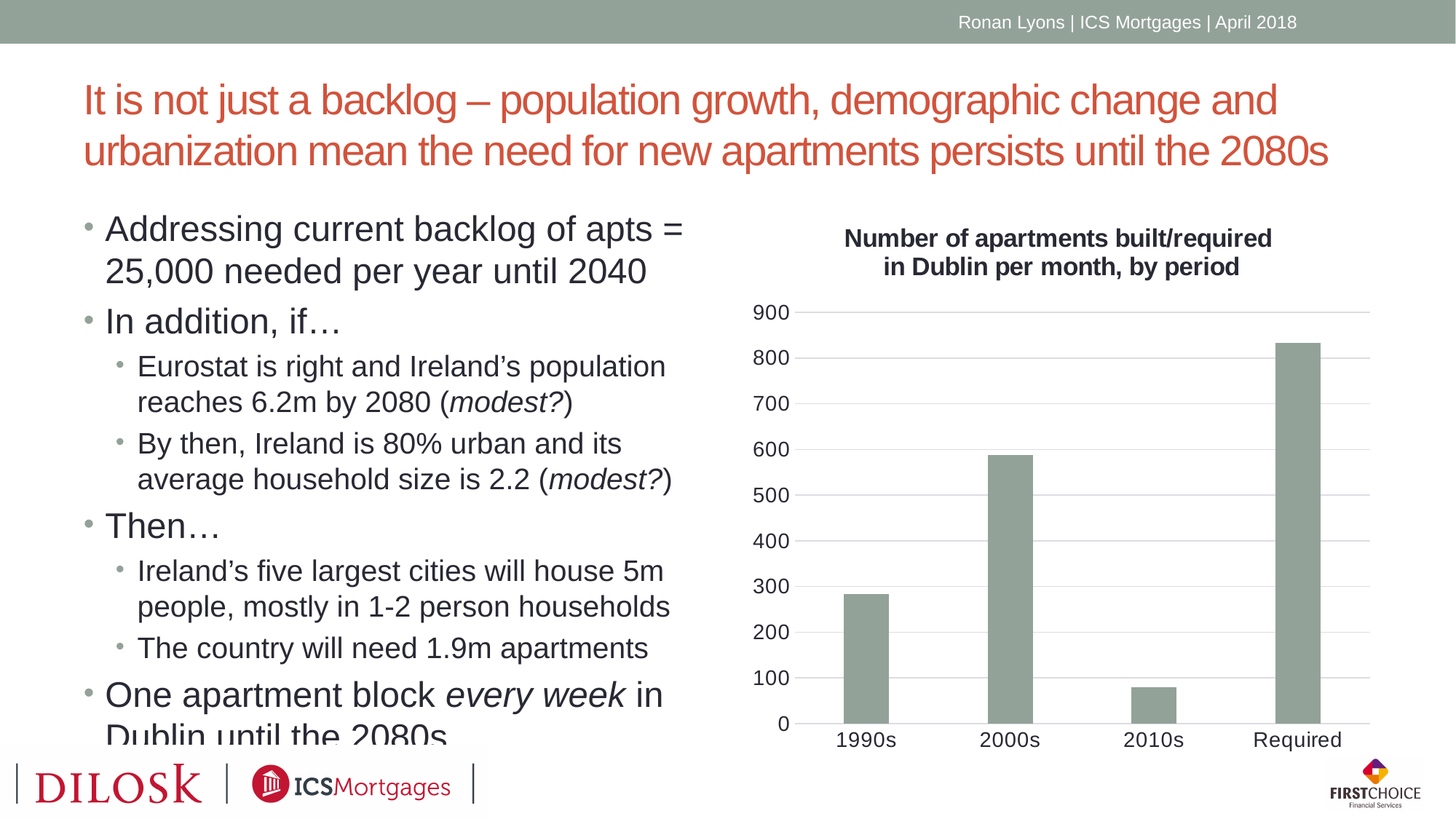
Is the value for Required greater or less than 800? greater Which category has the lowest bar? 2010s Which is larger, the value for 2000s or the value for 1990s? 2000s Is the value for 2000s greater or less than 500? greater What is the highest value shown on the vertical axis? 900 How many bars are plotted in the chart? 4 Which is larger, the value for 2010s or the value for Required? Required Which category has the highest bar? Required What is the title of the chart? Number of apartments built/required in Dublin per month, by period Is the value for 1990s greater or less than 200? greater What kind of chart is shown on the slide? bar chart